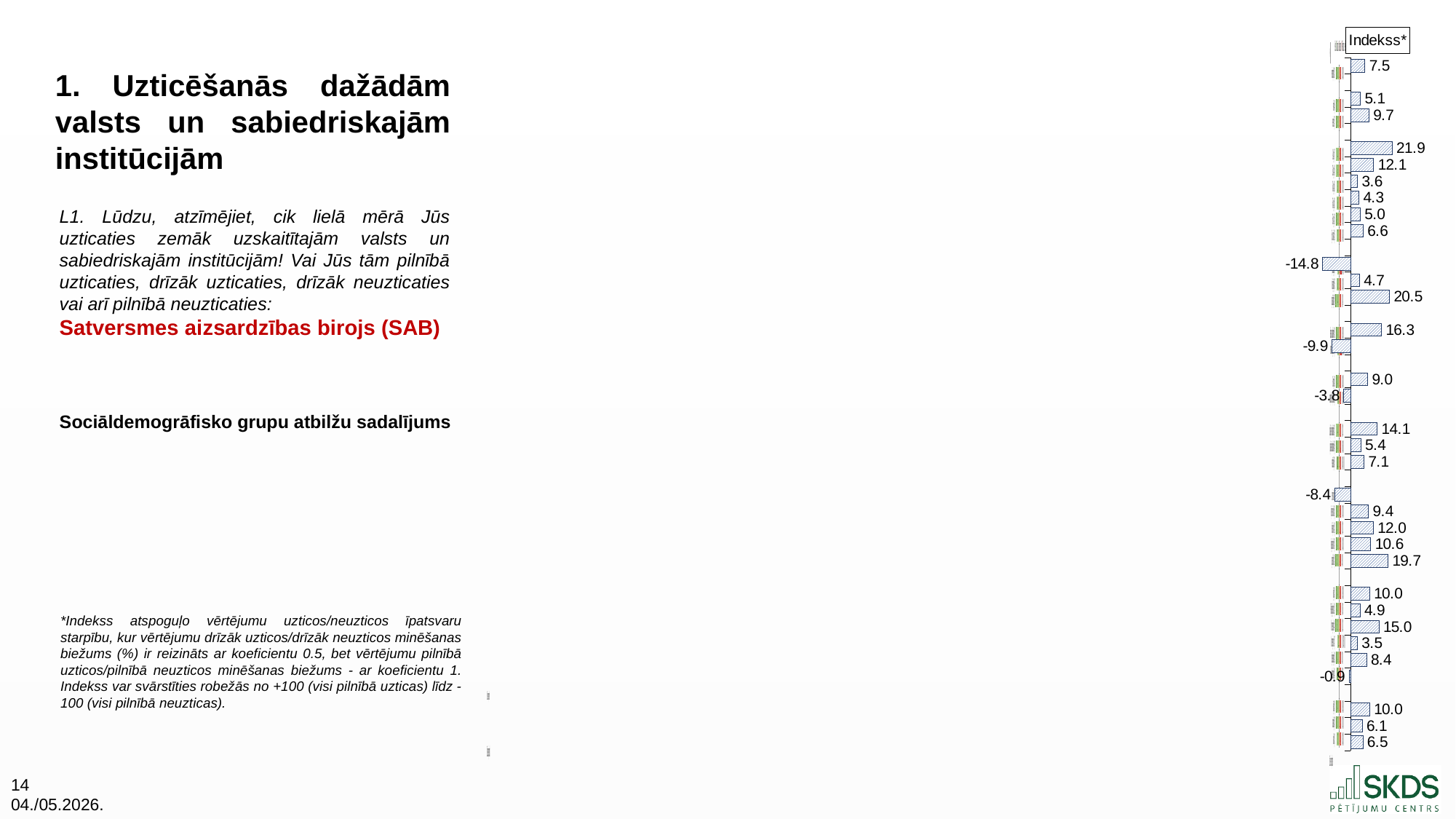
Is the highest index value on the chart greater or less than 20? greater How many negative index values are printed on the chart? 5 What is the difference between the highest index value (21.9) and the lowest index value (-14.8)? 36.7 Which is larger, the index value 20.5 or the index value 16.3? 20.5 What kind of chart is shown on the slide? bar chart What is the label shown in the box at the top of the chart? Indekss* What is the lowest index value shown in the chart? -14.8 How many index values printed on the chart are greater than 20? 2 What is the highest index value shown in the chart? 21.9